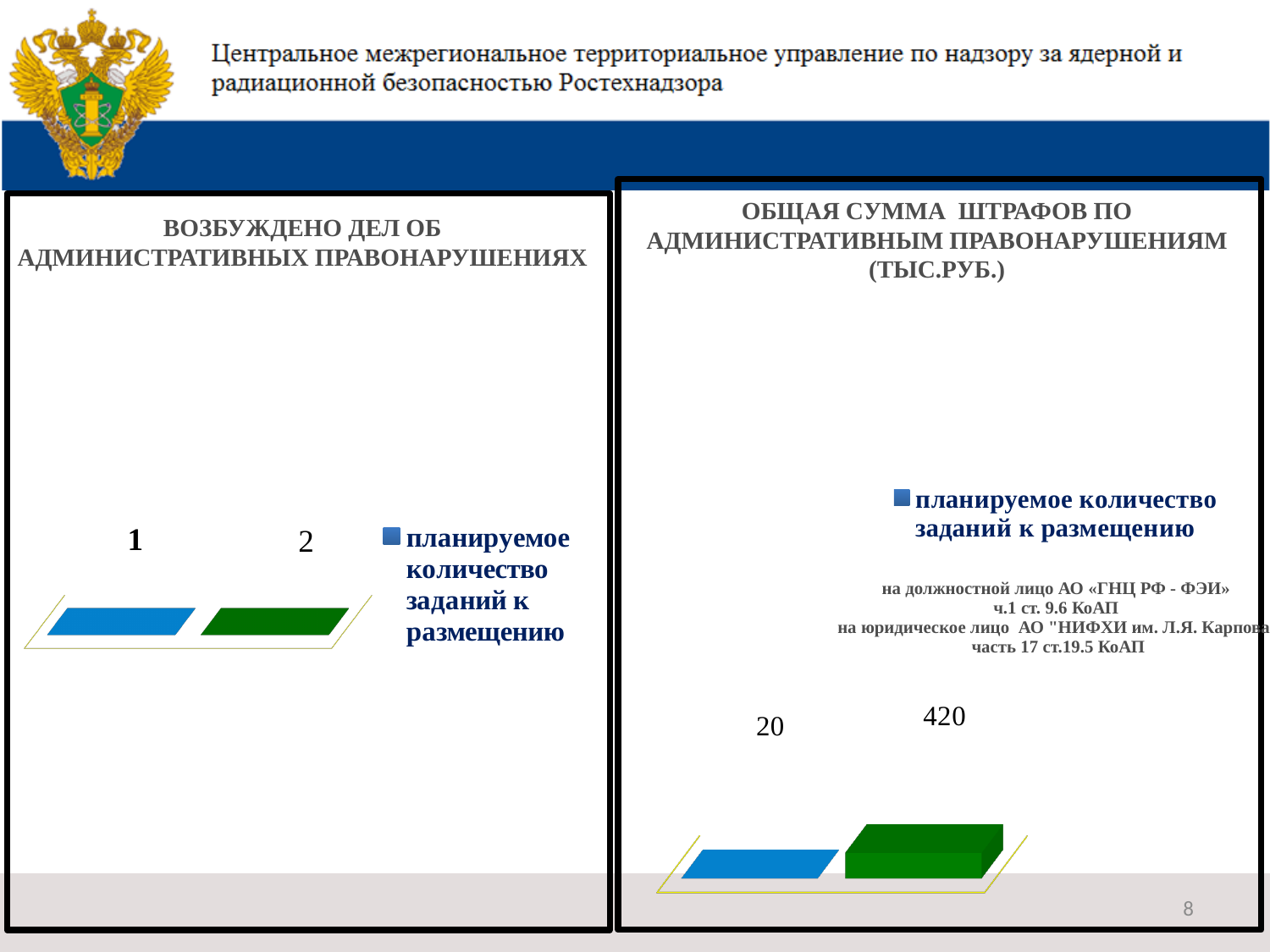
On the right chart 'ОБЩАЯ СУММА ШТРАФОВ ПО АДМИНИСТРАТИВНЫМ ПРАВОНАРУШЕНИЯМ (ТЫС.РУБ.)', what is the value of the blue bar? 20 On the right chart 'ОБЩАЯ СУММА ШТРАФОВ ПО АДМИНИСТРАТИВНЫМ ПРАВОНАРУШЕНИЯМ (ТЫС.РУБ.)', what is the difference between the two bar values? 400 On the left chart 'ВОЗБУЖДЕНО ДЕЛ ОБ АДМИНИСТРАТИВНЫХ ПРАВОНАРУШЕНИЯХ', what is the value of the left (blue) bar? 1 On the left chart 'ВОЗБУЖДЕНО ДЕЛ ОБ АДМИНИСТРАТИВНЫХ ПРАВОНАРУШЕНИЯХ', what is the difference between the two bar values? 1 On the left chart 'ВОЗБУЖДЕНО ДЕЛ ОБ АДМИНИСТРАТИВНЫХ ПРАВОНАРУШЕНИЯХ', how many bars are plotted? 2 On the right chart 'ОБЩАЯ СУММА ШТРАФОВ ПО АДМИНИСТРАТИВНЫМ ПРАВОНАРУШЕНИЯМ (ТЫС.РУБ.)', what is the total of the two bar values? 440 How many series does the legend of the right chart 'ОБЩАЯ СУММА ШТРАФОВ ПО АДМИНИСТРАТИВНЫМ ПРАВОНАРУШЕНИЯМ (ТЫС.РУБ.)' list? 1 On the right chart 'ОБЩАЯ СУММА ШТРАФОВ ПО АДМИНИСТРАТИВНЫМ ПРАВОНАРУШЕНИЯМ (ТЫС.РУБ.)', which bar is higher, the blue one or the green one? the green one On the left chart 'ВОЗБУЖДЕНО ДЕЛ ОБ АДМИНИСТРАТИВНЫХ ПРАВОНАРУШЕНИЯХ', what is the legend entry? планируемое количество заданий к размещению On the right chart 'ОБЩАЯ СУММА ШТРАФОВ ПО АДМИНИСТРАТИВНЫМ ПРАВОНАРУШЕНИЯМ (ТЫС.РУБ.)', what is the value of the green bar? 420 What type of chart is the right chart 'ОБЩАЯ СУММА ШТРАФОВ ПО АДМИНИСТРАТИВНЫМ ПРАВОНАРУШЕНИЯМ (ТЫС.РУБ.)'? bar chart On the left chart 'ВОЗБУЖДЕНО ДЕЛ ОБ АДМИНИСТРАТИВНЫХ ПРАВОНАРУШЕНИЯХ', what is the value of the right (green) bar? 2